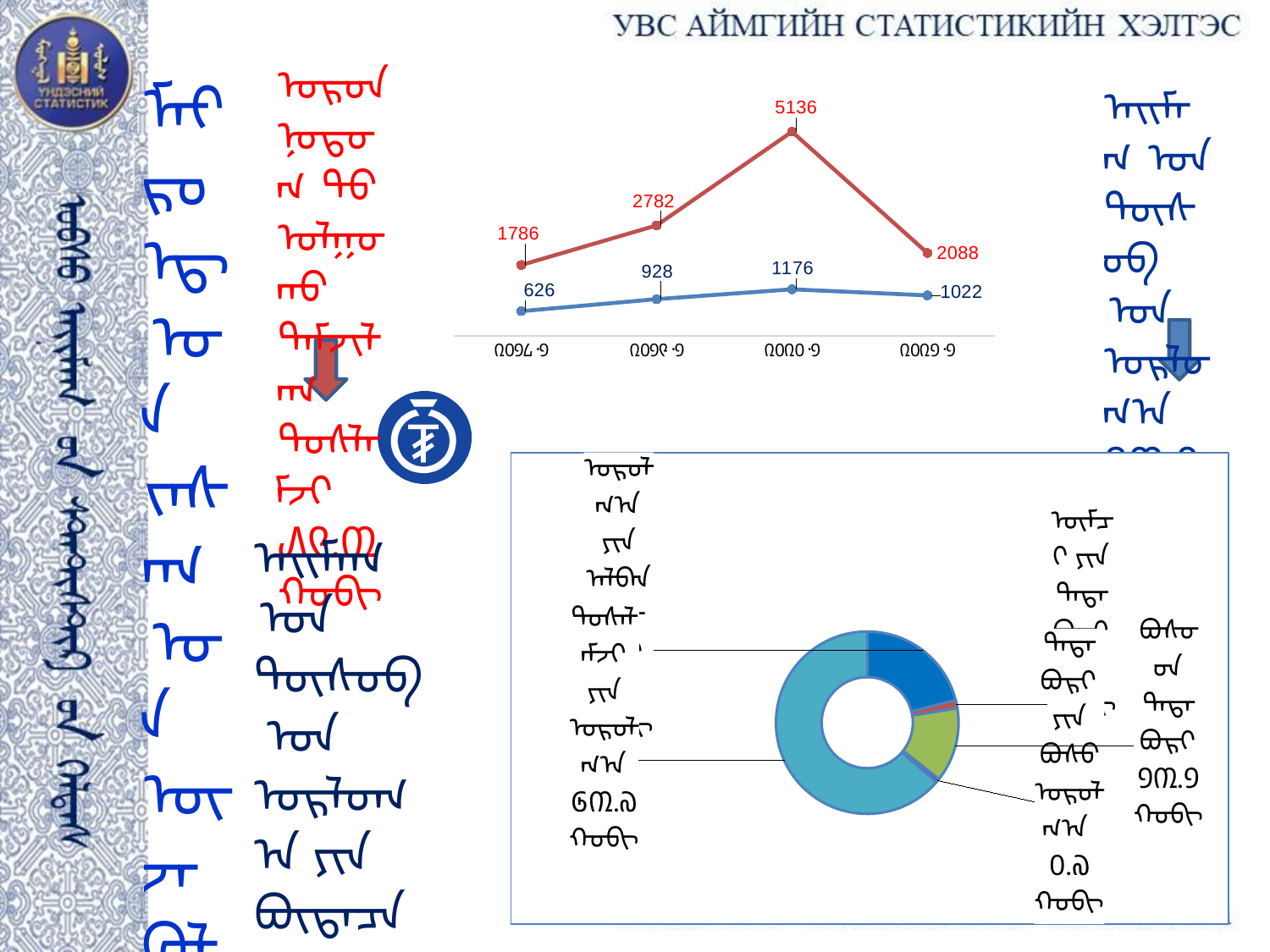
What kind of chart is the chart at the top of the slide? line chart In the line chart at the top of the slide, what is the value of the last point on the blue line? 1022 In the line chart at the top of the slide, what is the highest value on the red line? 5136 What kind of chart is the chart at the bottom of the slide? doughnut chart In the line chart at the top of the slide, how many lines are plotted? 2 In the line chart at the top of the slide, what is the highest value on the blue line? 1176 In the line chart at the top of the slide, which is larger at the last point: the red line value or the blue line value? the red line (2088) In the line chart at the top of the slide, how many data points does each line have? 4 In the line chart at the top of the slide, what is the lowest value on the red line? 1786 In the line chart at the top of the slide, what is the value of the first point on the blue line? 626 In the doughnut chart at the bottom of the slide, which colour slice is the largest? light blue In the line chart at the top of the slide, what is the difference between the second and first values on the red line (2782 and 1786)? 996